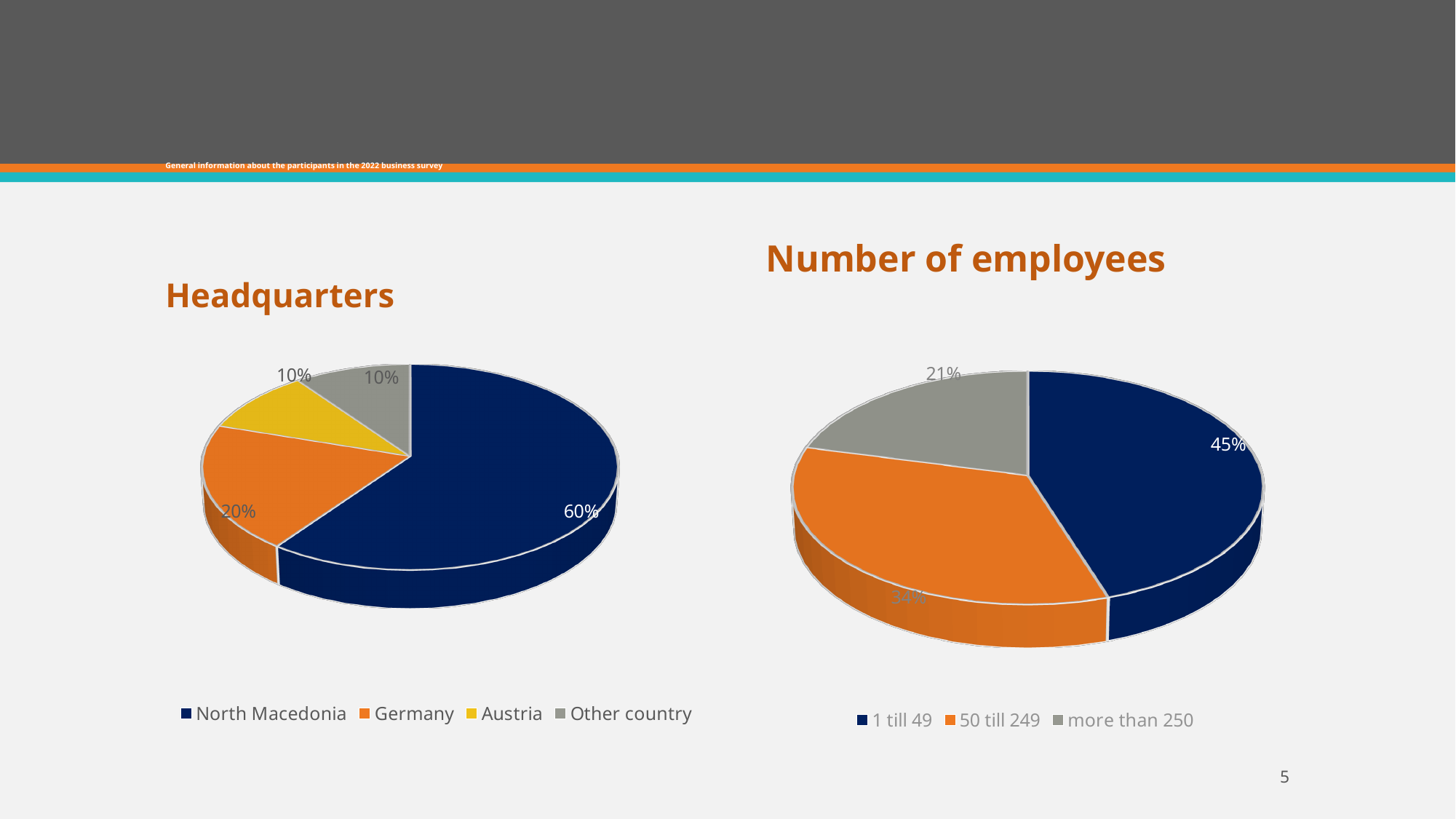
In the Number of employees chart, how many categories does the legend list? 3 In the Number of employees chart, what share is 1 till 49? 45% What kind of chart is the Headquarters chart? Pie chart In the Headquarters chart, what share is Germany? 20% In the Number of employees chart, what share is more than 250? 21% In the Headquarters chart, what is the difference between the North Macedonia and Germany shares? 40% In the Headquarters chart, which category has the largest share? North Macedonia In the Number of employees chart, which is larger: 1 till 49 or 50 till 249? 1 till 49 In the Number of employees chart, what is the difference between the 50 till 249 and more than 250 shares? 13% In the Number of employees chart, which category has the smallest share? more than 250 In the Headquarters chart, what share is North Macedonia? 60% In the Headquarters chart, how many categories does the legend list? 4